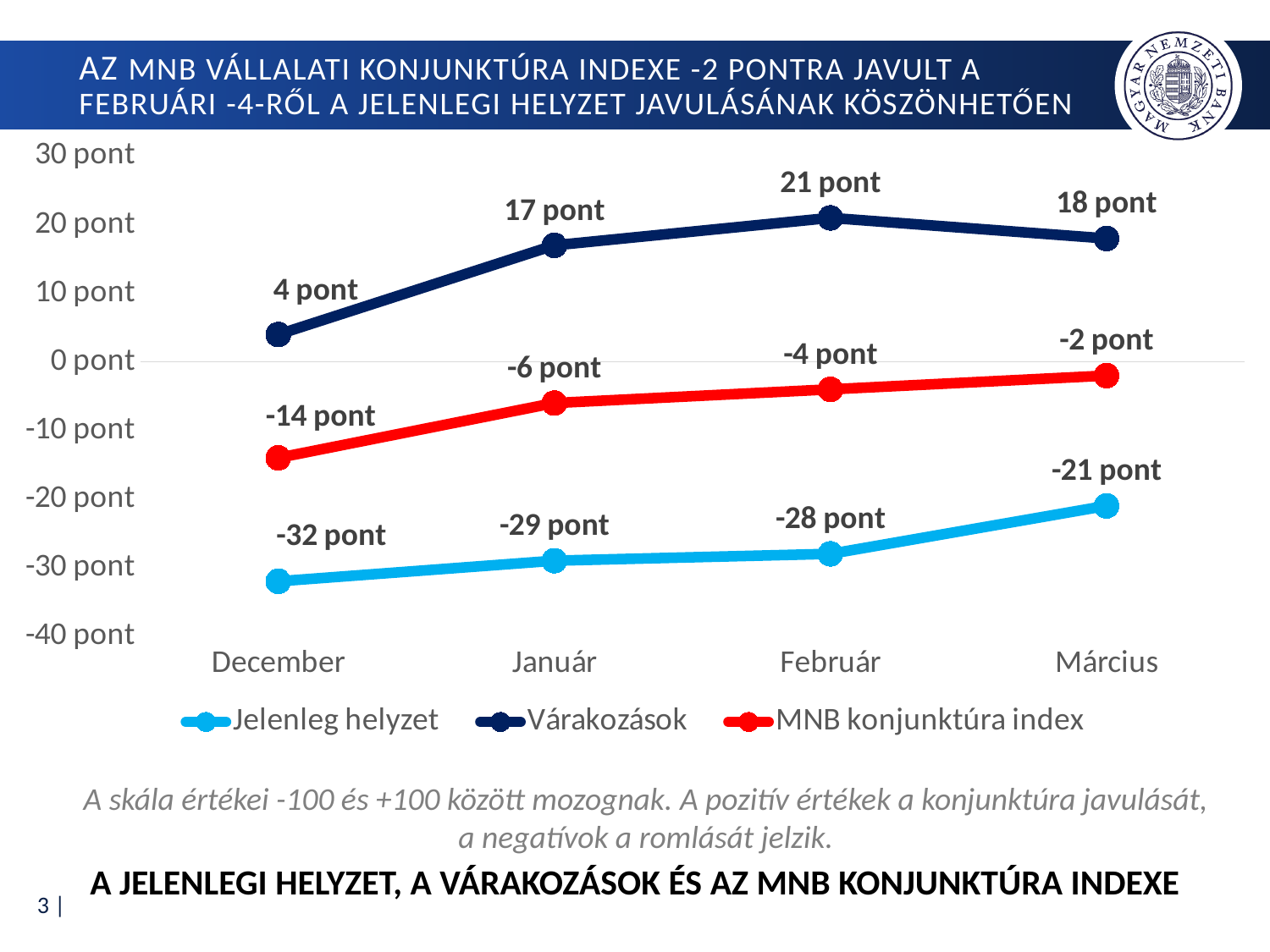
How many series does the legend list? 3 What type of chart is shown on the slide? Line chart In which month is the Jelenleg helyzet series at its lowest? December Does the MNB konjunktúra index rise or fall from December to Március? Rises What is the value of Jelenleg helyzet in December? -32 pont How many months are shown on the x axis? 4 Which is larger in Március: the Várakozások value or the MNB konjunktúra index value? Várakozások What is the value of Várakozások in Február? 21 pont In which month is the Várakozások series at its highest? Február What is the value of the MNB konjunktúra index in Március? -2 pont What is the difference between the Várakozások value and the Jelenleg helyzet value in Január? 46 pont Which colour is used for the Jelenleg helyzet series? Light blue